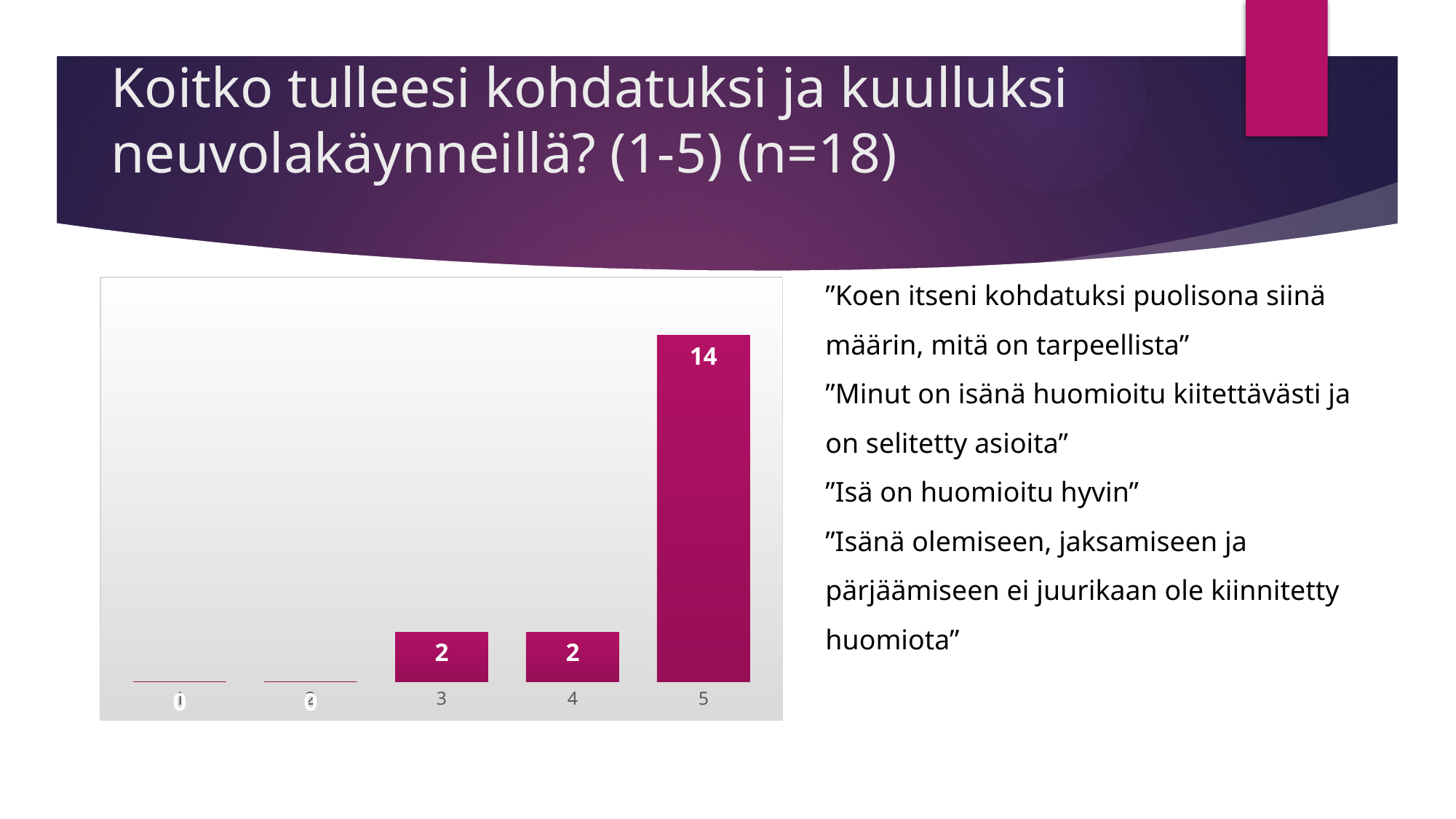
What is the sample size (n) stated in the slide title? 18 Do the values generally rise or fall from category 1 to category 5? rise Which is larger, the value for category 5 or the value for category 3? category 5 What is the value for category 5? 14 What is the value for category 4? 2 What kind of chart is shown on the slide? bar chart Which category has the highest value? 5 What is the value for category 3? 2 How many categories are shown on the x axis? 5 What colour are the bars in the chart? magenta What is the difference between the values for category 5 and category 4? 12 What is the difference between the values for category 5 and category 3? 12